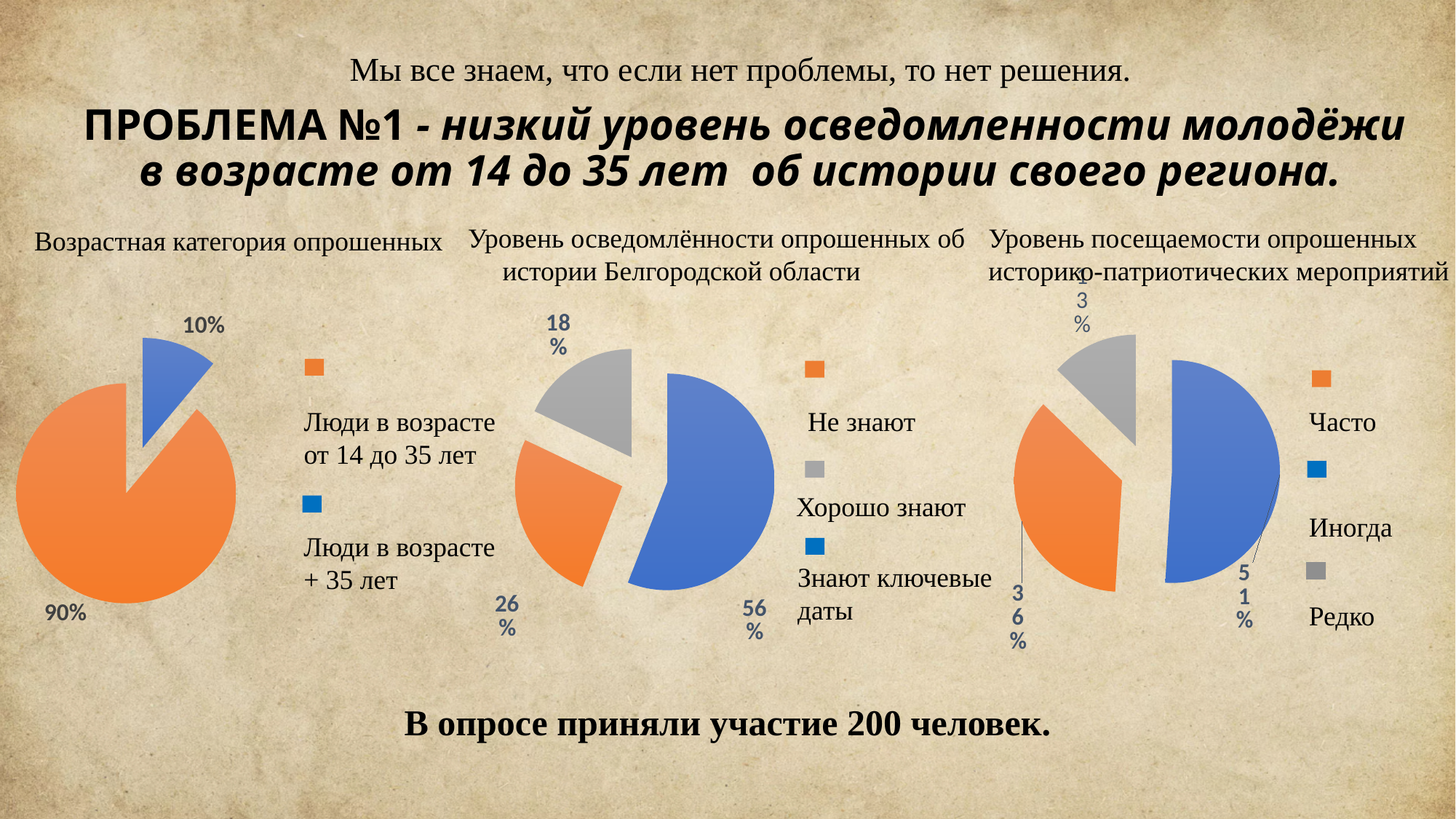
In the chart 'Уровень посещаемости опрошенных историко-патриотических мероприятий', what share is 'Часто'? 36% In the chart 'Уровень посещаемости опрошенных историко-патриотических мероприятий', what share is 'Иногда'? 51% In the chart 'Уровень осведомлённости опрошенных об истории Белгородской области', what share is 'Знают ключевые даты'? 56% In the chart 'Возрастная категория опрошенных', what share is 'Люди в возрасте от 14 до 35 лет'? 90% In the chart 'Возрастная категория опрошенных', what share is 'Люди в возрасте + 35 лет'? 10% In the chart 'Уровень осведомлённости опрошенных об истории Белгородской области', which category has the smallest share? Хорошо знают In the chart 'Возрастная категория опрошенных', how many slices does the pie have? 2 In the chart 'Уровень посещаемости опрошенных историко-патриотических мероприятий', which category has the largest share? Иногда In the chart 'Уровень осведомлённости опрошенных об истории Белгородской области', what share is 'Не знают'? 26% What kind of chart is used for 'Возрастная категория опрошенных'? pie chart In the chart 'Уровень осведомлённости опрошенных об истории Белгородской области', what share is 'Хорошо знают'? 18% In the chart 'Уровень осведомлённости опрошенных об истории Белгородской области', what is the difference between 'Знают ключевые даты' and 'Не знают'? 30%